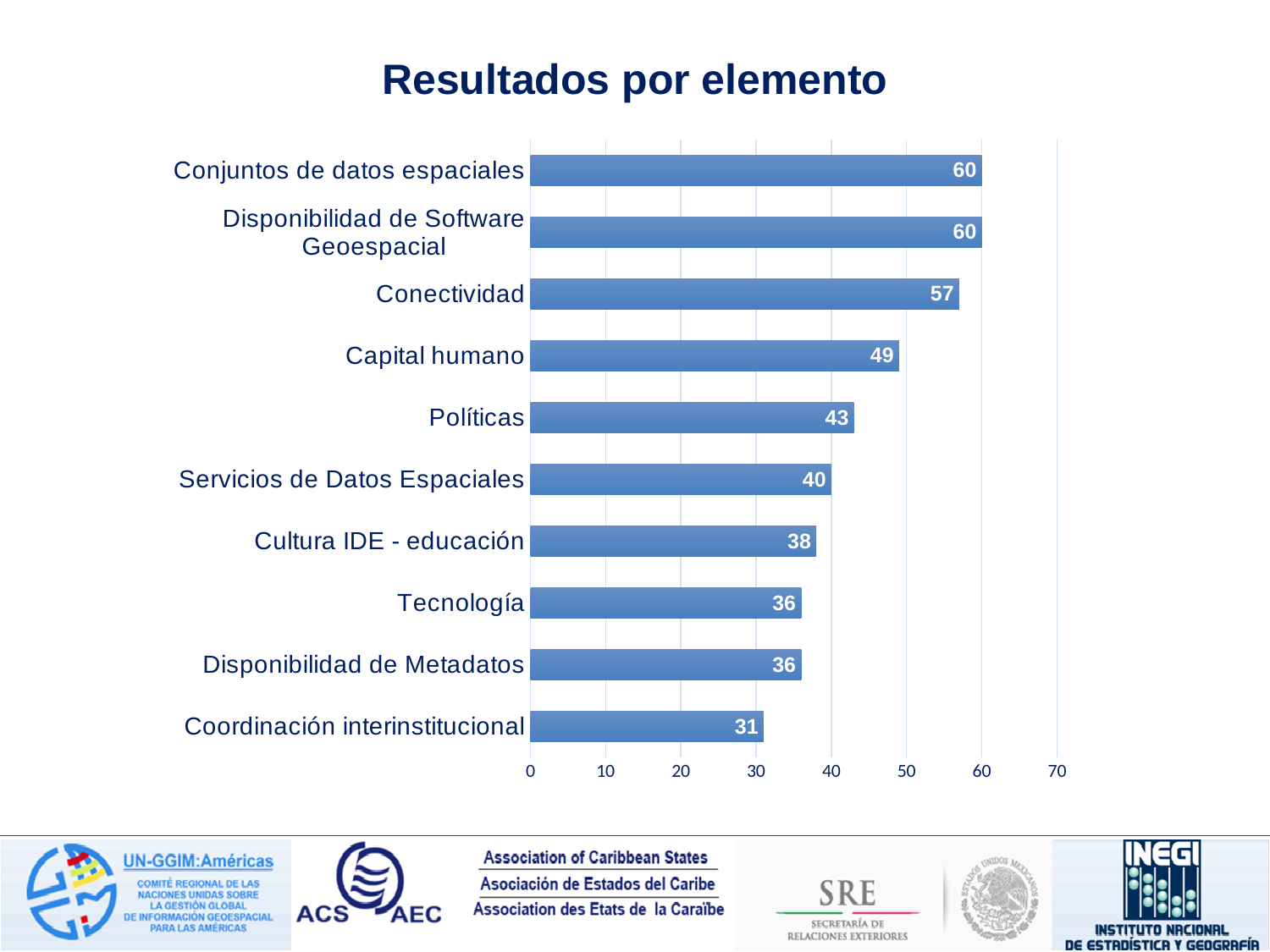
What is the highest value shown on the x axis? 70 What is the value for Capital humano? 49 What is the value for Cultura IDE - educación? 38 What is the difference between the values for Conectividad and Políticas? 14 What is the title of the chart? Resultados por elemento How many categories are shown in the chart? 10 Is the value for Capital humano greater or less than 40? greater What kind of chart is shown on the slide? bar chart What is the value for Coordinación interinstitucional? 31 Which category has the lowest value? Coordinación interinstitucional Which is larger, the value for Servicios de Datos Espaciales or the value for Tecnología? Servicios de Datos Espaciales What is the value for Conectividad? 57